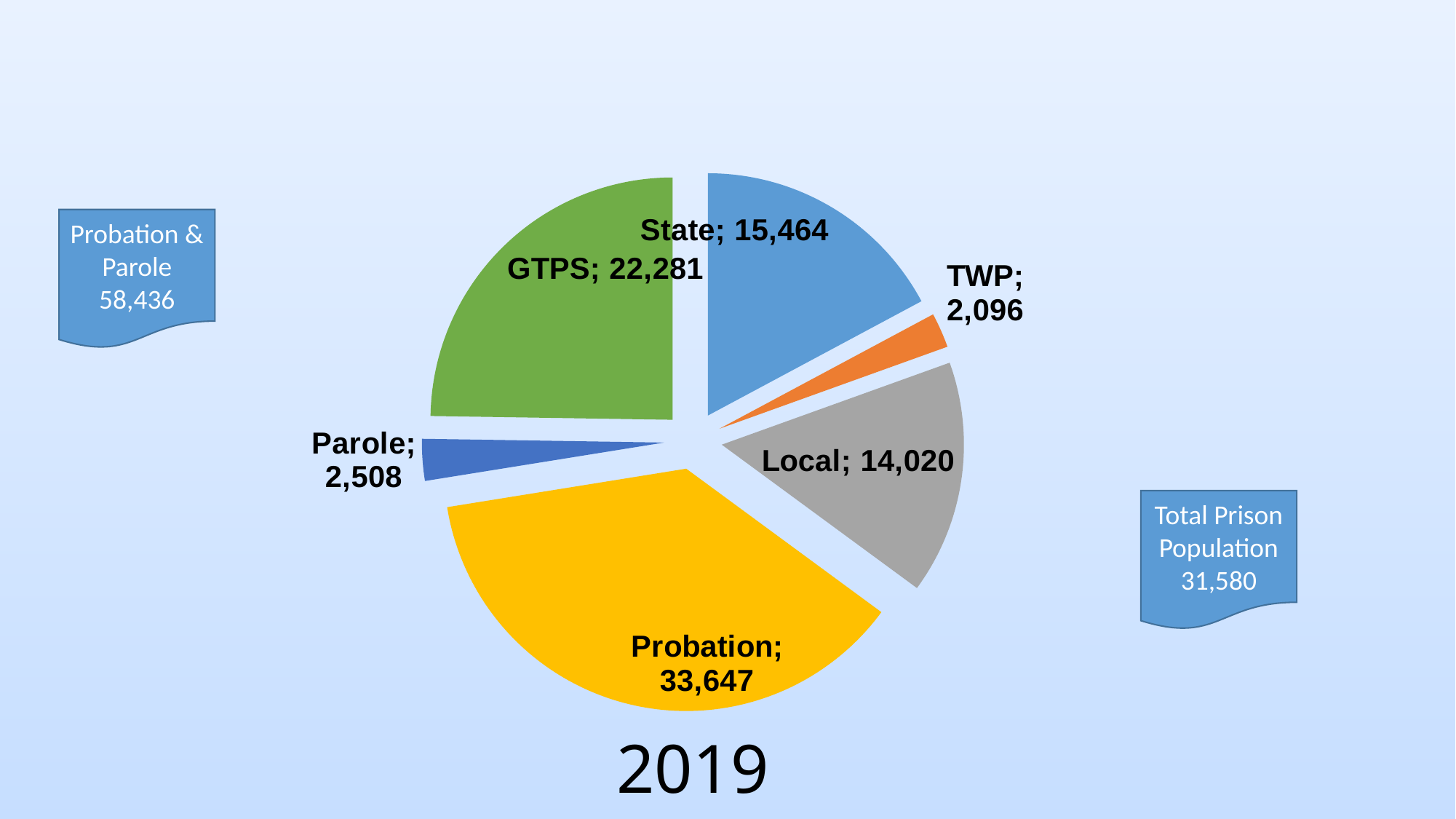
What is the value for Local in the pie chart? 14,020 What is the difference between the Probation value and the GTPS value? 11,366 What is the value for GTPS in the pie chart? 22,281 What is the value for TWP in the pie chart? 2,096 What year is shown as the title below the pie chart? 2019 What type of chart is shown on the slide? Pie chart What is the difference between the Parole value and the TWP value? 412 Which category has the smallest slice in the pie chart? TWP How many slices does the pie chart have? 6 Which category has the largest slice in the pie chart? Probation Which is larger, the value for State or the value for Local? State What is the value for Probation in the pie chart? 33,647